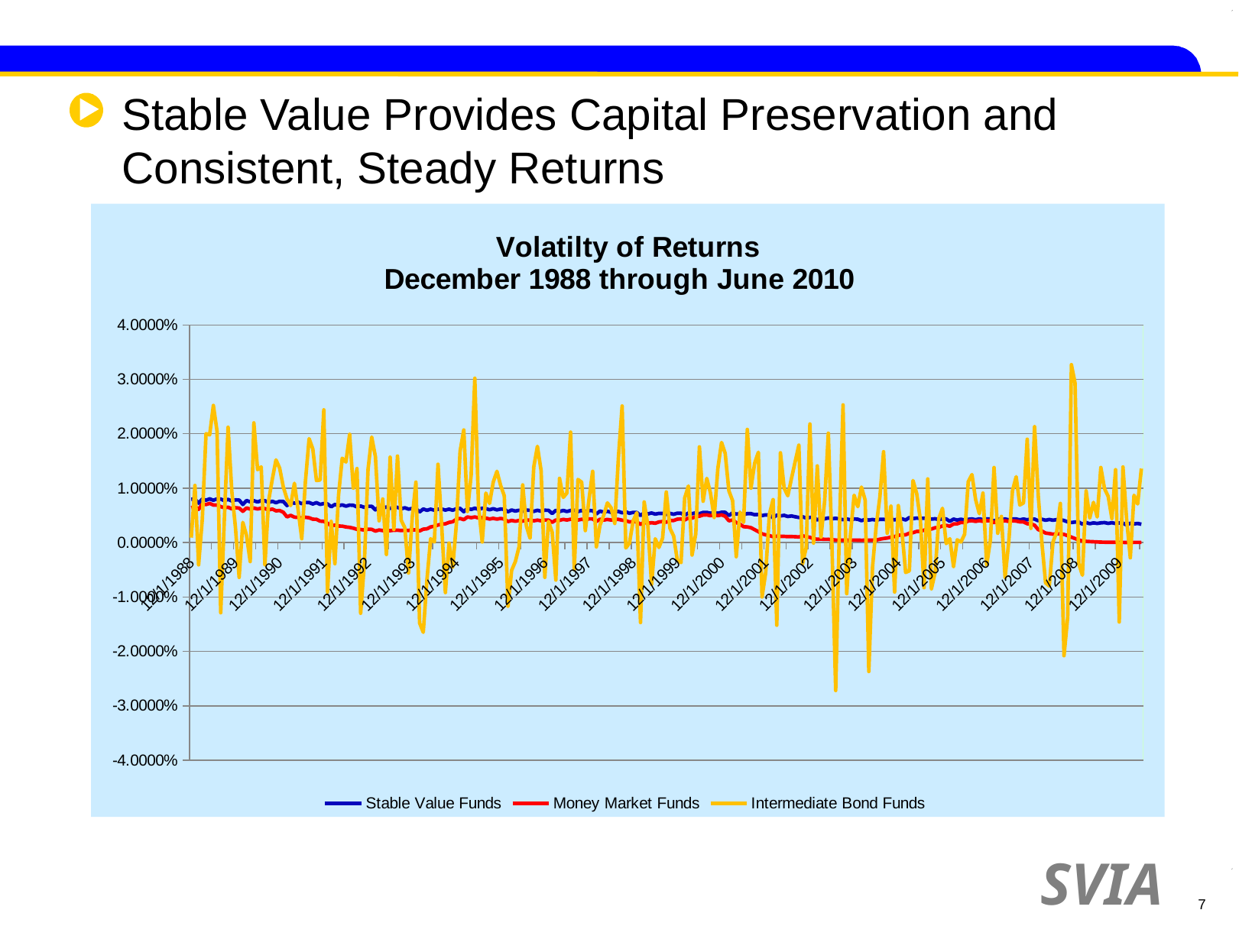
What is the title of the chart? Volatilty of Returns December 1988 through June 2010 Which series reaches the highest value on the chart? Intermediate Bond Funds How many date labels are shown along the x axis? 22 Is the highest peak of Intermediate Bond Funds greater or less than 3.0000%? greater Does the Money Market Funds line generally rise or fall from 12/1/1989 to 12/1/2009? fall Which colour is used for the Intermediate Bond Funds line? yellow What kind of chart is shown on the slide? line chart At 12/1/2009, which is higher: Stable Value Funds or Money Market Funds? Stable Value Funds How many series does the legend list? 3 Which series reaches the lowest value on the chart? Intermediate Bond Funds Is the value for Stable Value Funds at 12/1/2009 greater or less than 1.0000%? less Is the lowest point of Intermediate Bond Funds greater or less than -2.0000%? less